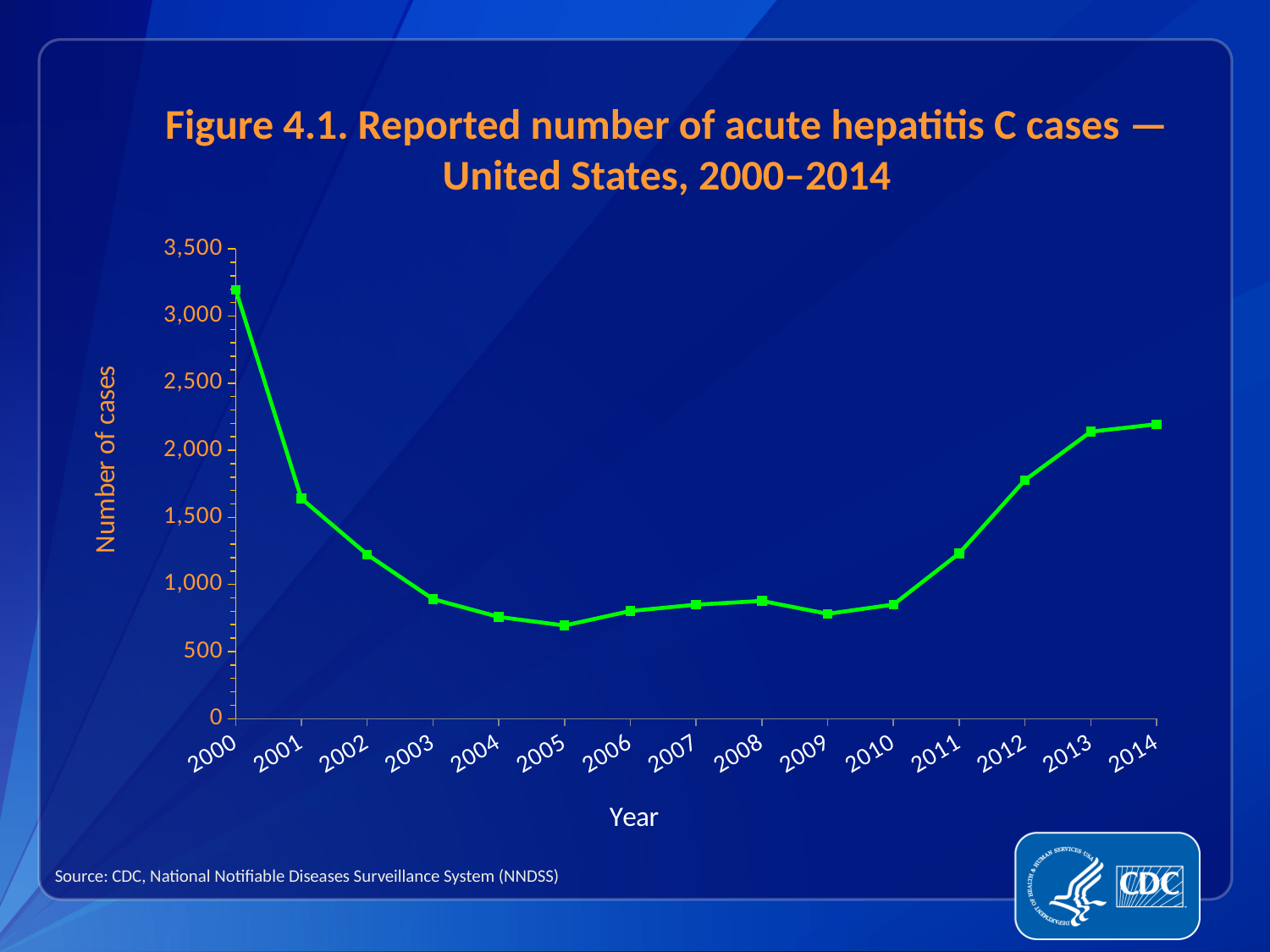
Which year has the lowest reported number of acute hepatitis C cases? 2005 Which year has the highest reported number of acute hepatitis C cases? 2000 What kind of chart is shown on the slide? line chart How many years are plotted on the x axis? 15 Is the value for 2001 greater or less than 1,500? greater Is the value for 2013 greater or less than 2,000? greater Is the value for 2012 greater or less than 2,000? less What is the label on the vertical axis? Number of cases Which year has more reported cases, 2000 or 2014? 2000 Do the reported cases rise or fall from 2010 to 2014? rise